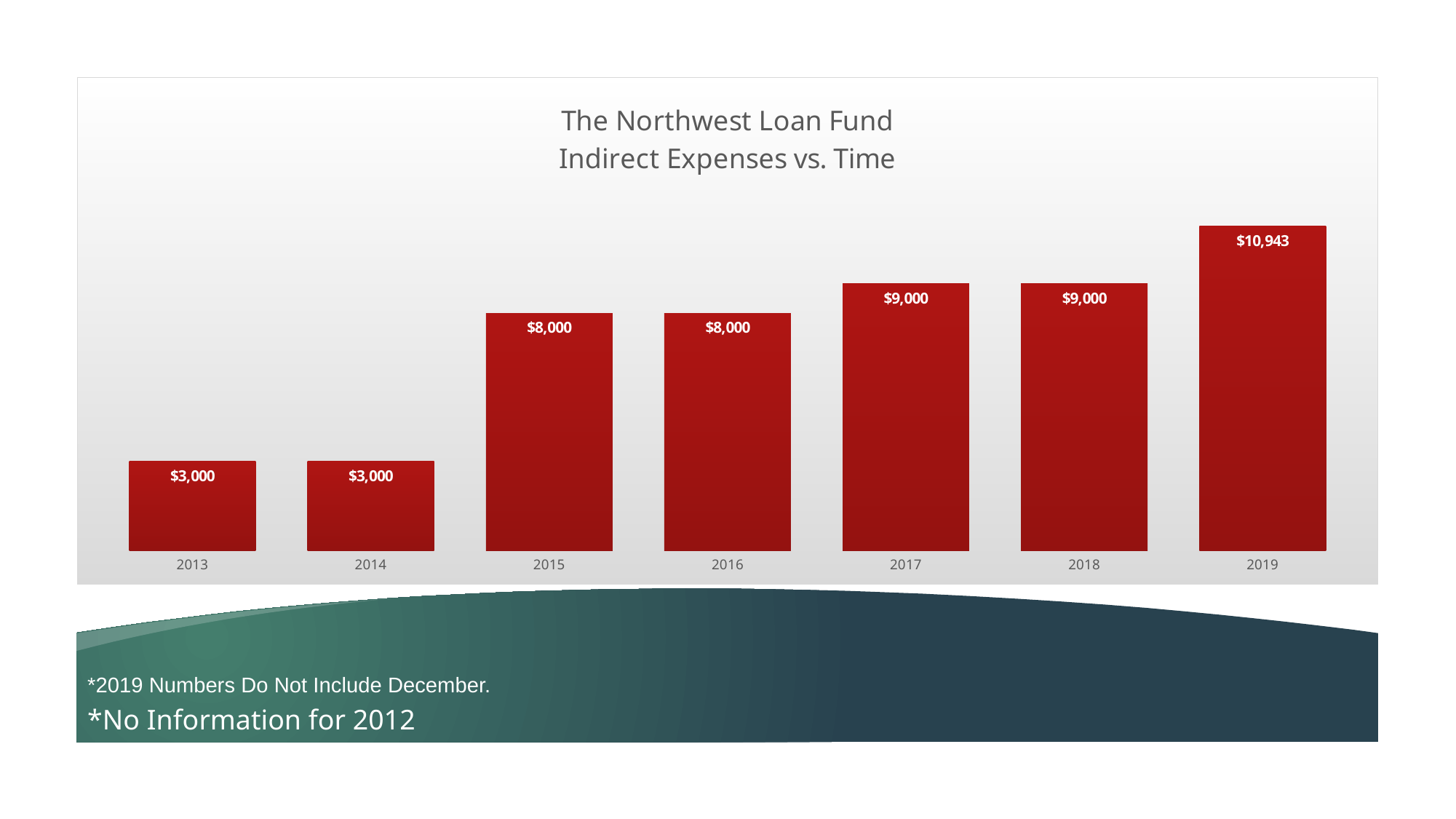
How many years are shown on the x axis? 7 What is the value for 2018? $9,000 What kind of chart is shown? Bar chart What is the value for 2013? $3,000 What is the difference between the values for 2015 and 2014? $5,000 Do the values generally rise or fall from 2013 to 2019? Rise What is the value for 2015? $8,000 What is the title of the chart? The Northwest Loan Fund Indirect Expenses vs. Time Which year has the highest value? 2019 Which is larger, the value for 2017 or the value for 2016? 2017 What is the value for 2019? $10,943 What is the difference between the values for 2019 and 2018? $1,943